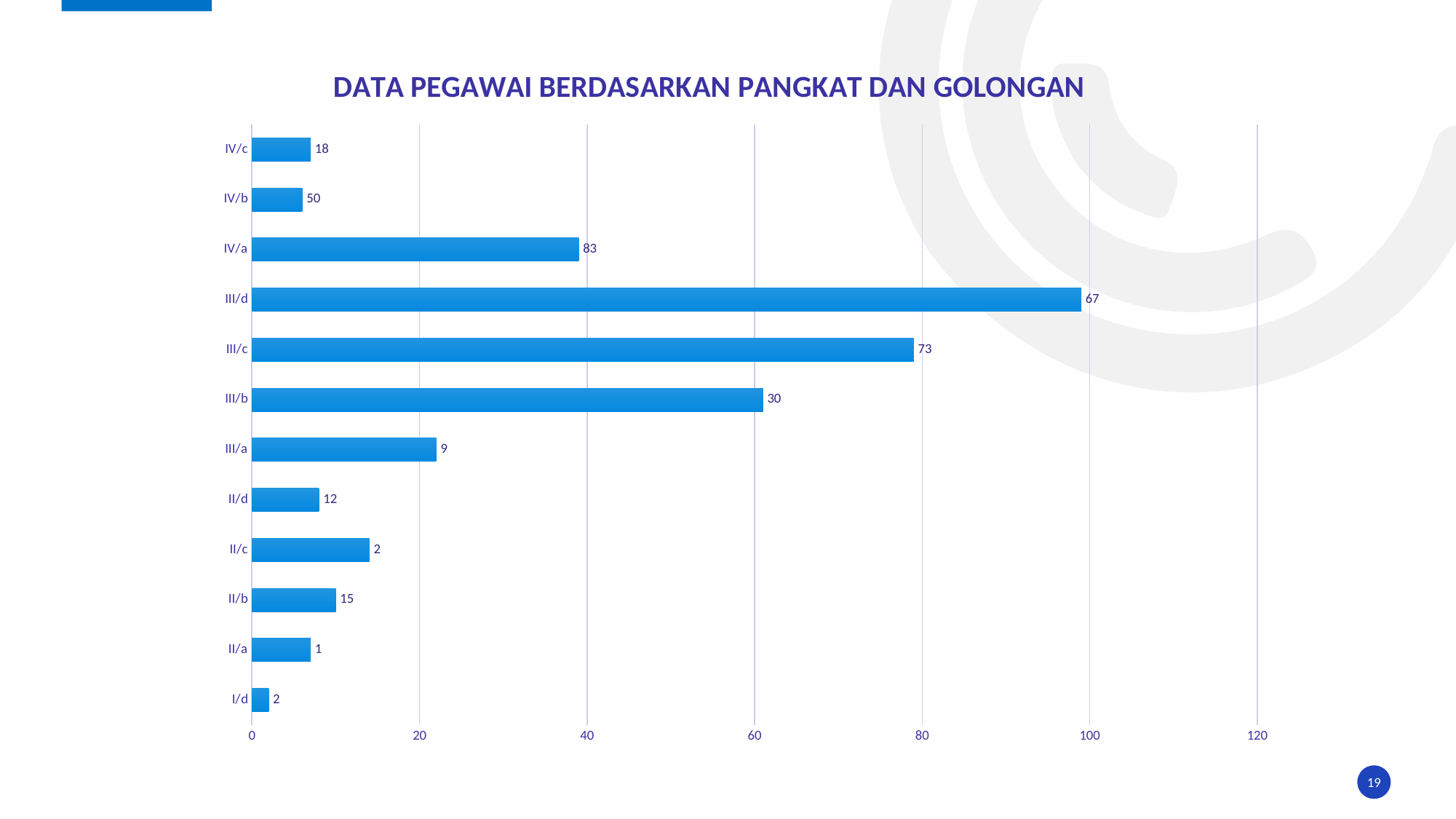
What is the title of the chart? DATA PEGAWAI BERDASARKAN PANGKAT DAN GOLONGAN What is the value for III/d? 67 What is the difference between the labelled values for IV/a and III/c? 10 What is the value for IV/a? 83 What is the value for II/b? 15 What is the value for III/b? 30 What is the value for I/d? 2 How many categories (pangkat/golongan) are shown on the chart? 12 What kind of chart is shown on the slide? Bar chart What is the value for III/c? 73 What is the value for IV/b? 50 What is the value for II/a? 1